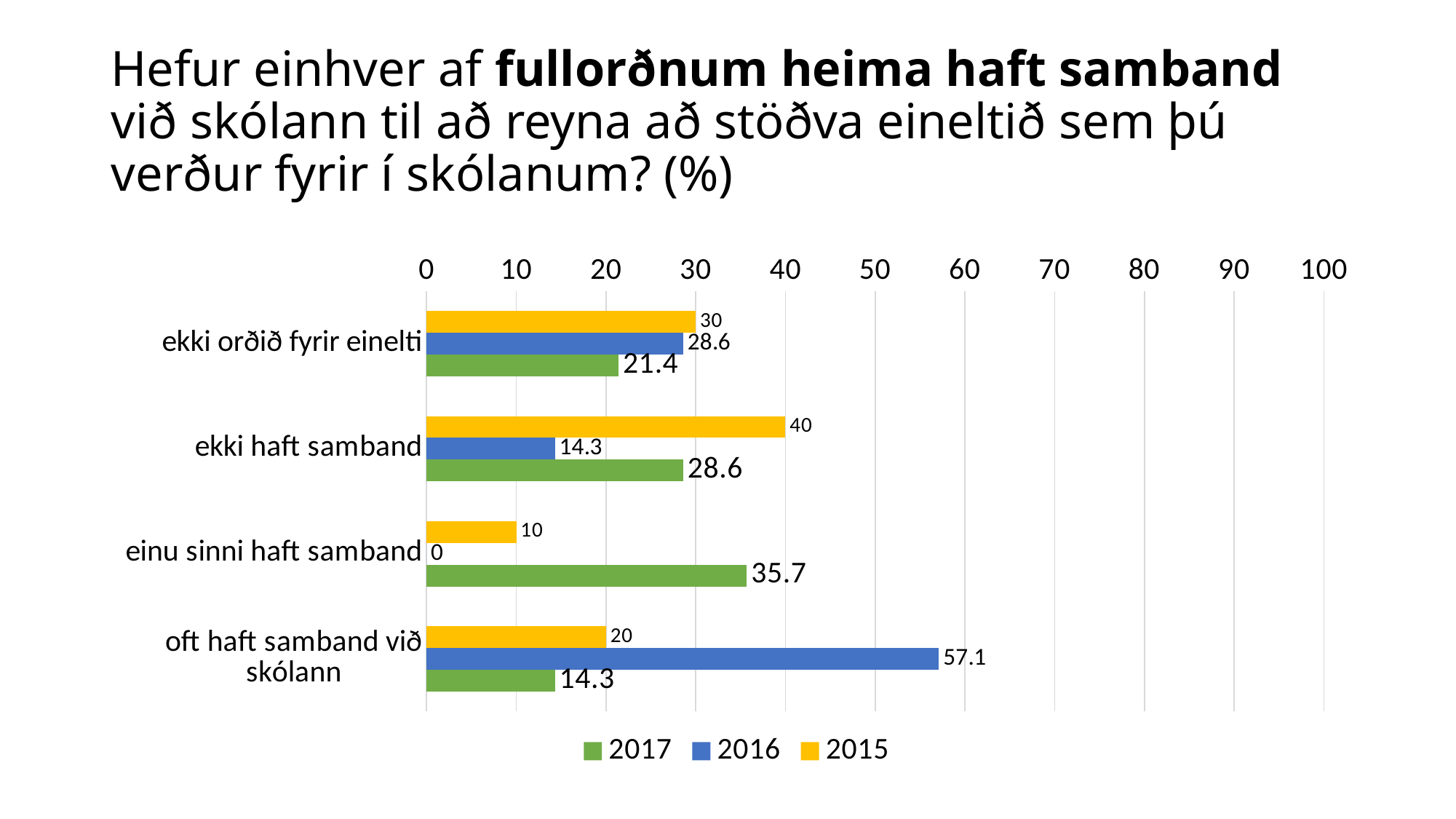
What is the 2017 value for "einu sinni haft samband"? 35.7 What is the difference between the 2015 and 2016 values for "ekki haft samband"? 25.7 What is the 2016 value for "einu sinni haft samband"? 0 What is the 2016 value for "oft haft samband við skólann"? 57.1 What is the 2015 value for "ekki haft samband"? 40 Is the 2016 value for "oft haft samband við skólann" greater or less than 50? greater For "ekki orðið fyrir einelti", which year has the larger value, 2015 or 2017? 2015 Which category has the lowest 2015 value? einu sinni haft samband What kind of chart is shown on the slide? bar chart How many categories are shown on the chart? 4 Which category has the highest 2017 value? einu sinni haft samband How many series does the legend list? 3